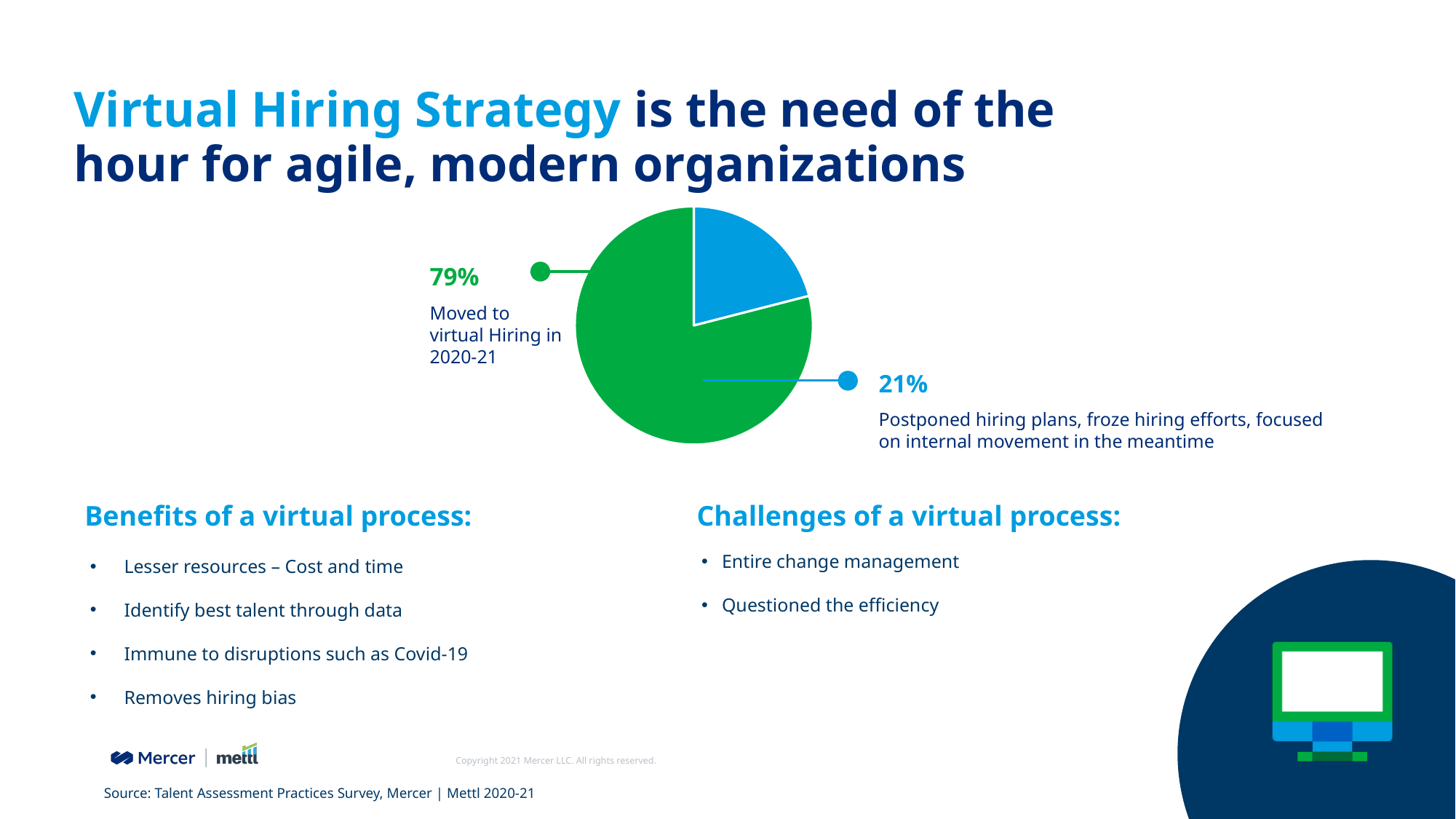
What colour is the slice representing organizations that moved to virtual hiring in 2020-21? green What colour is the slice representing organizations that postponed hiring plans? blue What is the total of the two pie chart slices? 100% Which is larger: the share that moved to virtual hiring or the share that postponed hiring plans? Moved to virtual hiring What kind of chart is shown on the slide? pie chart Which slice of the pie chart is the smallest? Postponed hiring plans, froze hiring efforts, focused on internal movement in the meantime How many slices does the pie chart have? 2 What percentage of organizations postponed hiring plans, froze hiring efforts, or focused on internal movement? 21% What percentage of organizations moved to virtual hiring in 2020-21? 79% What is the difference in percentage points between the share that moved to virtual hiring and the share that postponed hiring plans? 58 Which slice of the pie chart is the largest? Moved to virtual Hiring in 2020-21